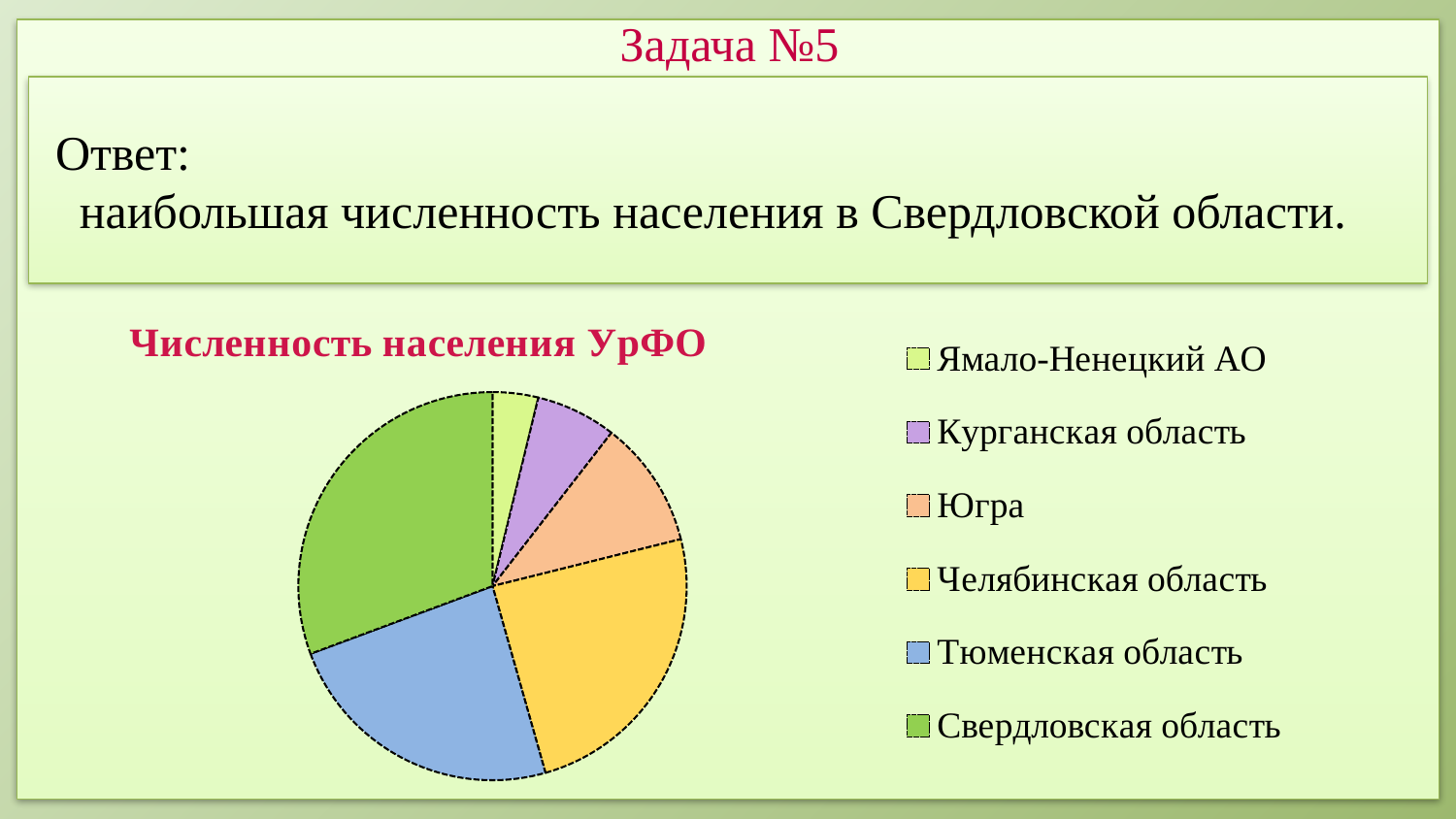
Which region has the largest slice of the pie chart? Свердловская область Which slice is larger: Югра or Курганская область? Югра Which region has the smallest slice of the pie chart? Ямало-Ненецкий АО Which slice is larger: Челябинская область or Курганская область? Челябинская область Which slice is larger: Тюменская область or Ямало-Ненецкий АО? Тюменская область What kind of chart is shown on the slide? pie chart Which region is represented by the blue slice in the pie chart? Тюменская область How many regions (slices) does the pie chart show? 6 What is the title of the chart? Численность населения УрФО